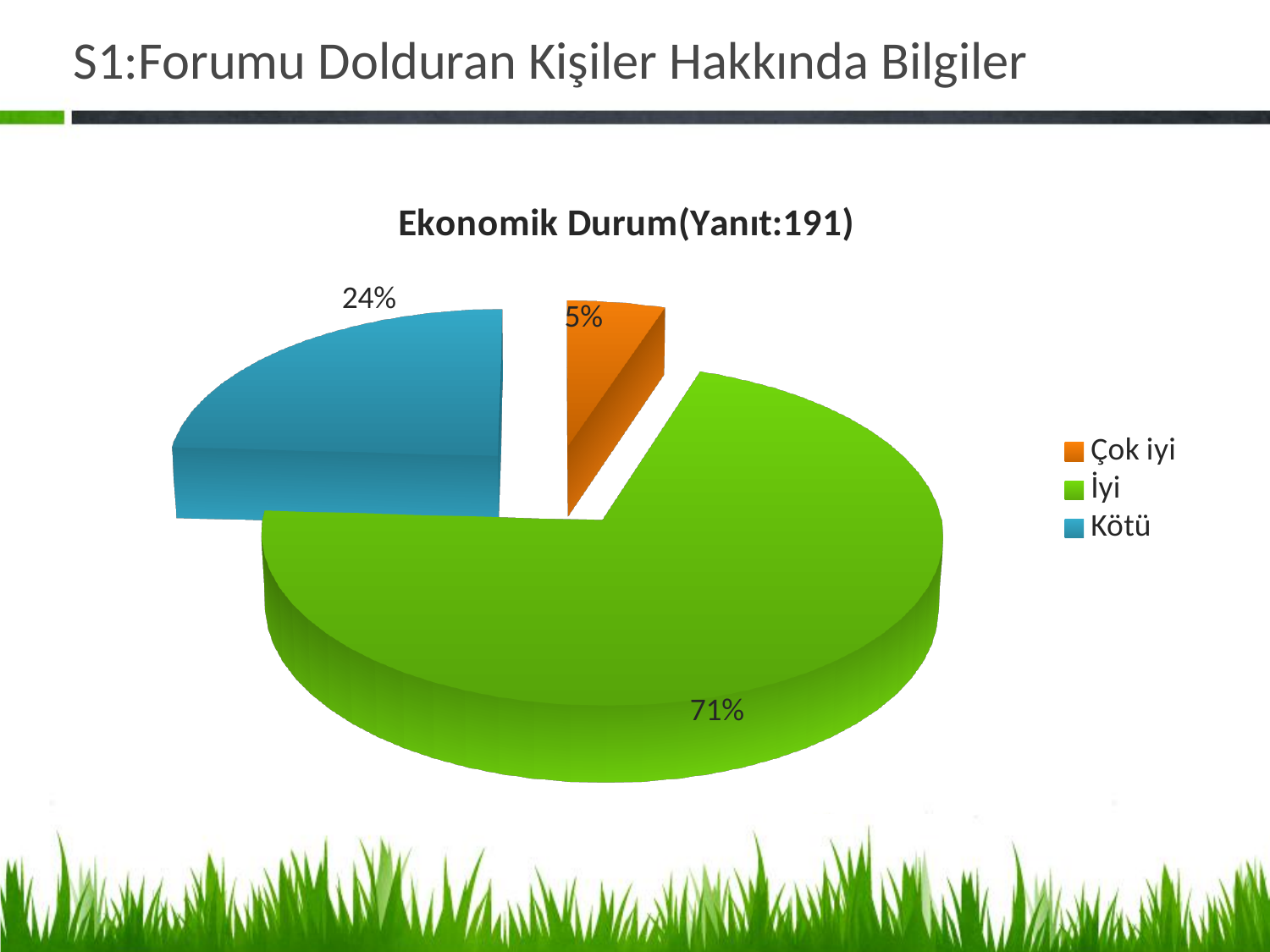
How many slices does the pie chart have? 3 What kind of chart is shown on the slide? Pie chart Which category has the smallest slice of the pie? Çok iyi Which slice is larger, Kötü or Çok iyi? Kötü What share of the pie does the Kötü slice represent? 24% What share of the pie does the Çok iyi slice represent? 5% What is the title of the chart? Ekonomik Durum(Yanıt:191) What colour is the Kötü slice in the pie chart? Blue What share of the pie does the İyi slice represent? 71% How many entries does the legend list? 3 Which category has the largest slice of the pie? İyi What is the difference in percentage points between the İyi and Kötü slices? 47